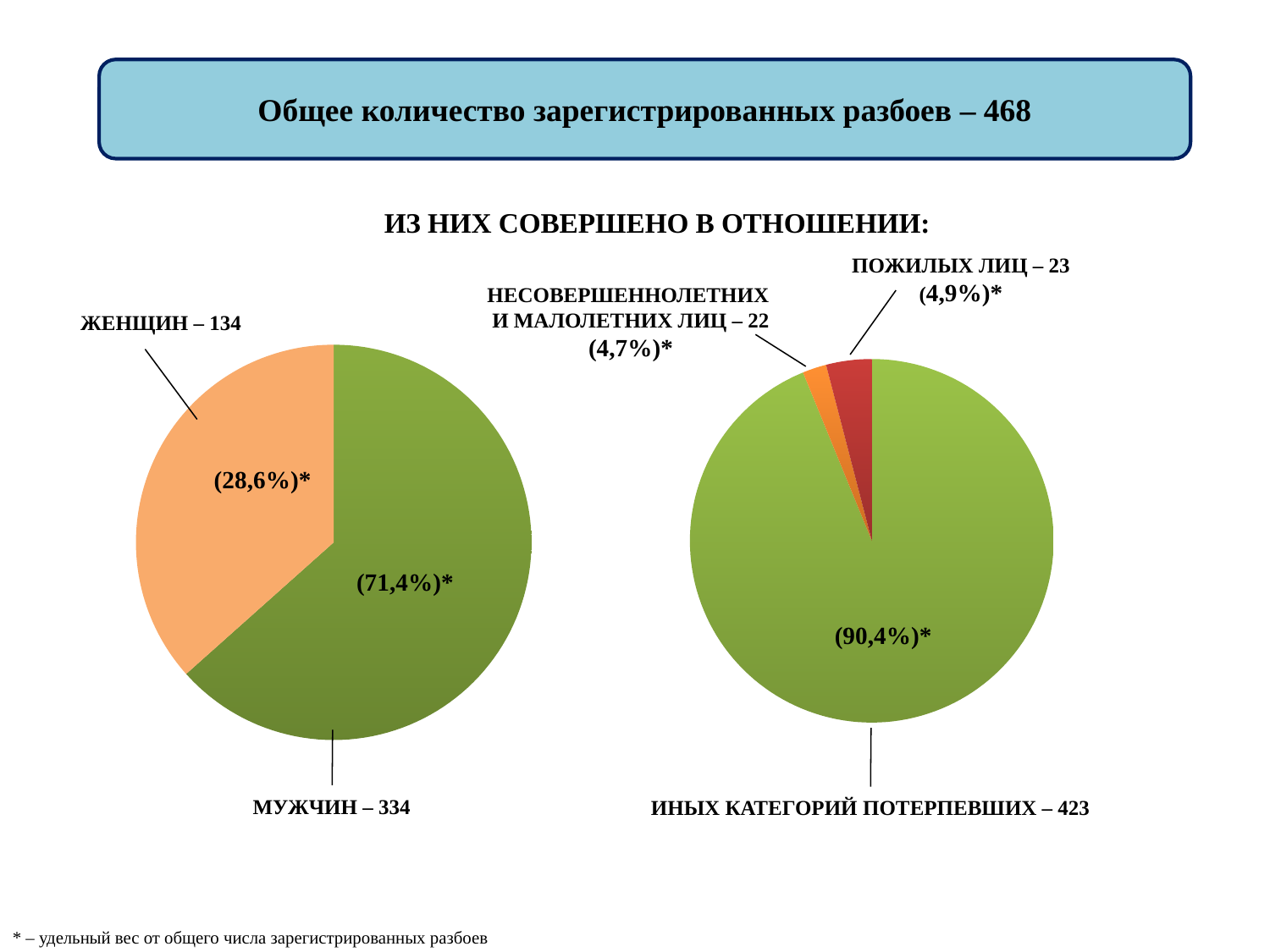
In the right pie chart, how many robberies were committed against minors and juveniles (НЕСОВЕРШЕННОЛЕТНИХ И МАЛОЛЕТНИХ ЛИЦ)? 22 In the left pie chart, how many robberies were committed against men (МУЖЧИН)? 334 In the left pie chart, what share of the total do robberies against women (ЖЕНЩИН) represent? 28,6% In the left pie chart, what is the difference between the number of robberies against men and against women? 200 In the right pie chart, how many robberies were committed against elderly persons (ПОЖИЛЫХ ЛИЦ)? 23 What is the total number of registered robberies stated at the top of the slide? 468 What type of chart is used on the left side of the slide? Pie chart In the left pie chart, what share of the total do robberies against men (МУЖЧИН) represent? 71,4% In the left pie chart, how many robberies were committed against women (ЖЕНЩИН)? 134 How many slices does the right pie chart have? 3 In the right pie chart, what share of the total do other categories of victims (ИНЫХ КАТЕГОРИЙ ПОТЕРПЕВШИХ) represent? 90,4% In the right pie chart, which category has the largest slice? ИНЫХ КАТЕГОРИЙ ПОТЕРПЕВШИХ